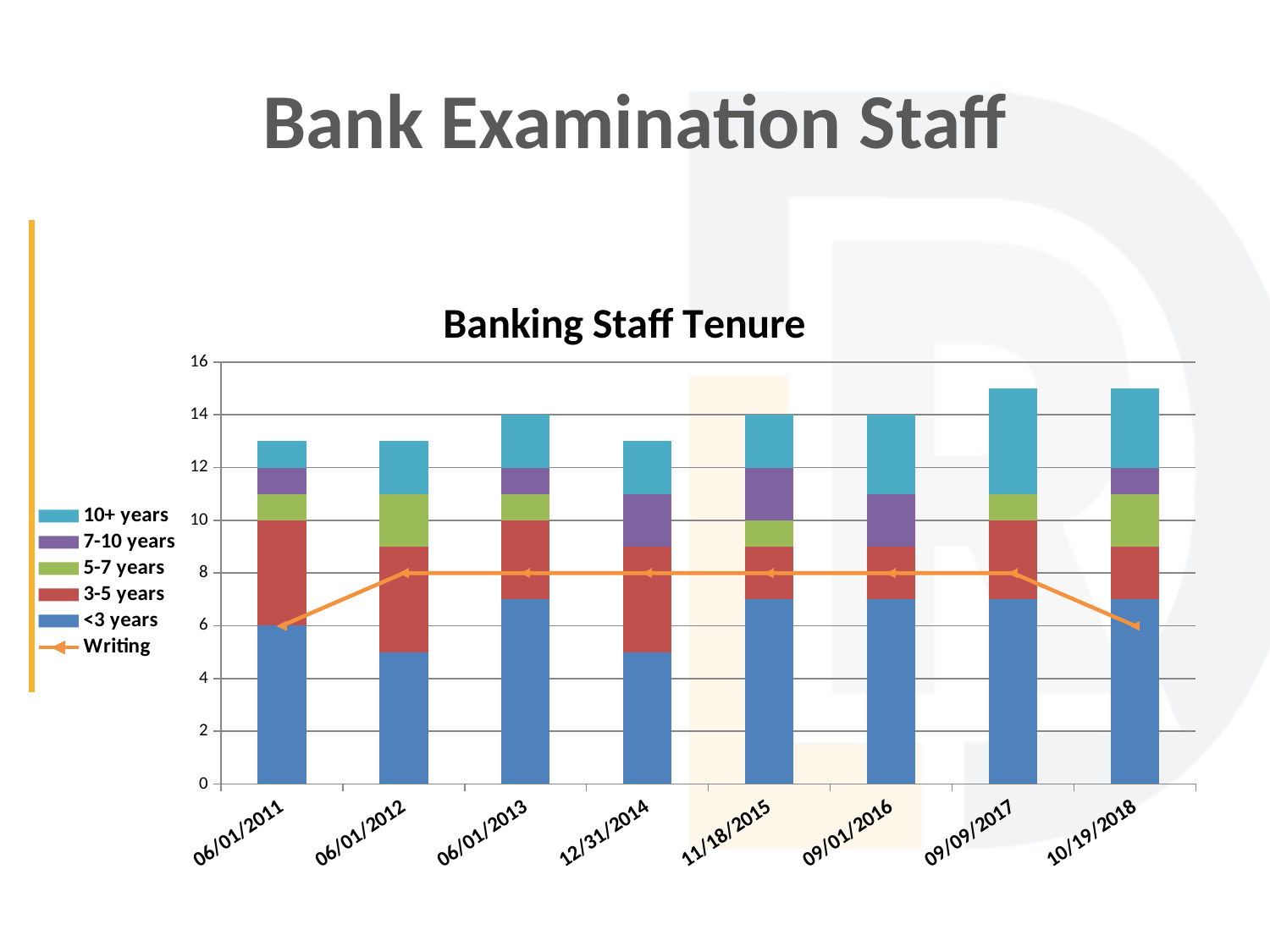
Is the total height of the stacked bar for 09/09/2017 greater or less than 14? greater How many series does the legend list? 6 What is the value of the Writing line at 06/01/2012? 8 How many dates are shown along the x axis? 8 What kind of chart is shown on the slide? Stacked bar chart with a line Which has a taller stacked bar, 09/09/2017 or 06/01/2011? 09/09/2017 What is the value of the Writing line at 10/19/2018? 6 What is the title of the chart? Banking Staff Tenure Does the Writing line rise or fall from 06/01/2011 to 06/01/2012? rise What is the value of the <3 years segment at 06/01/2011? 6 What is the total height of the stacked bar for 06/01/2013? 14 Is the total height of the stacked bar for 06/01/2011 greater or less than 14? less